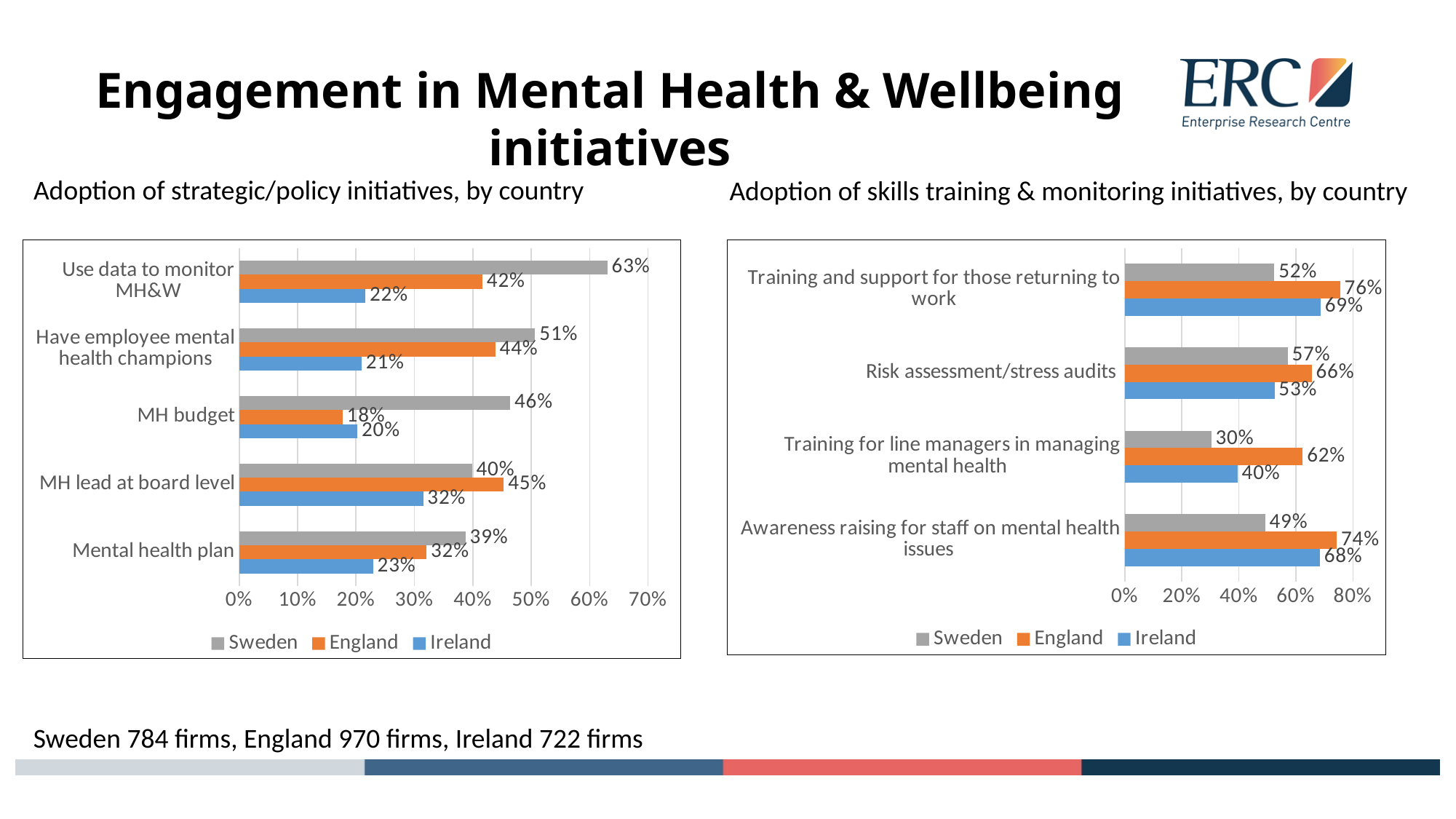
In the 'Adoption of skills training & monitoring initiatives, by country' chart, which country has the highest value for 'Risk assessment/stress audits'? England What type of chart is the 'Adoption of skills training & monitoring initiatives, by country' chart? Bar chart In the 'Adoption of skills training & monitoring initiatives, by country' chart, what is the value for Sweden for 'Training for line managers in managing mental health'? 30% In the 'Adoption of skills training & monitoring initiatives, by country' chart, what is the value for England for 'Training and support for those returning to work'? 76% In the 'Adoption of skills training & monitoring initiatives, by country' chart, what is the difference between England and Ireland for 'Awareness raising for staff on mental health issues'? 6% How many series does the legend list in the 'Adoption of skills training & monitoring initiatives, by country' chart? 3 In the 'Adoption of strategic/policy initiatives, by country' chart, which country has the lowest value for 'MH budget'? England In the 'Adoption of strategic/policy initiatives, by country' chart, what is the difference between Sweden and Ireland for 'Have employee mental health champions'? 30% In the 'Adoption of strategic/policy initiatives, by country' chart, what is the value for Ireland for 'MH lead at board level'? 32% In the 'Adoption of strategic/policy initiatives, by country' chart, what is the value for Sweden for 'Use data to monitor MH&W'? 63% How many categories are shown in the 'Adoption of strategic/policy initiatives, by country' chart? 5 In the 'Adoption of strategic/policy initiatives, by country' chart, which is larger for 'MH lead at board level': Sweden or England? England